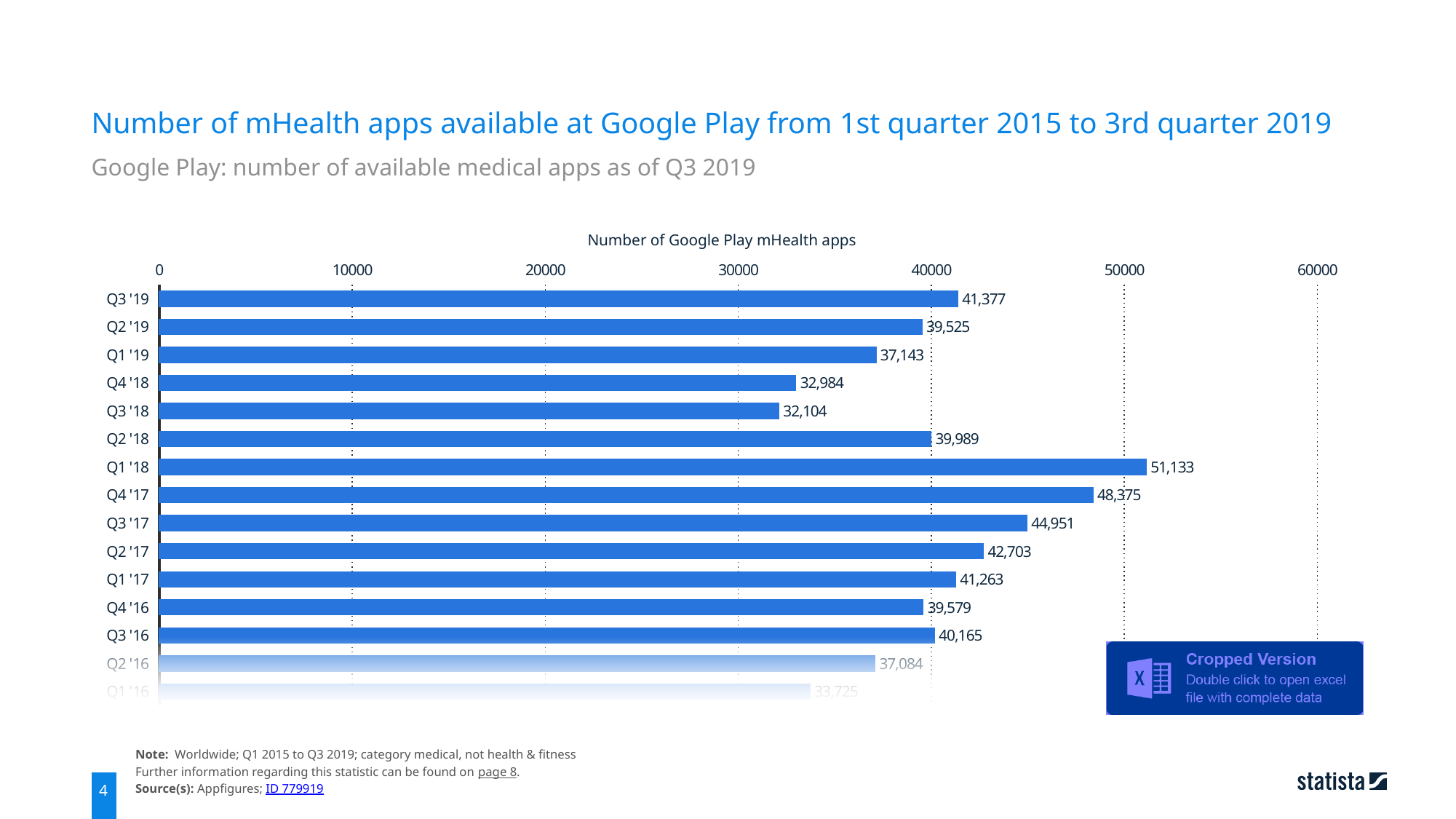
What is the number of mHealth apps available at Google Play in Q3 '19? 41,377 Which is larger, the value for Q2 '18 or the value for Q3 '18? Q2 '18 What is the difference between the values for Q3 '19 and Q2 '19? 1,852 What is the difference between the values for Q1 '18 and Q4 '17? 2,758 What is the title of the chart's value axis? Number of Google Play mHealth apps Is the value for Q1 '18 greater or less than 50000? greater What is the value shown for Q4 '17? 48,375 What is the value shown for Q3 '16? 40,165 What kind of chart is shown on the slide? bar chart Which quarter has the lowest number of Google Play mHealth apps among the clearly labelled bars? Q3 '18 Which quarter has the highest number of Google Play mHealth apps? Q1 '18 What is the value shown for Q1 '18? 51,133